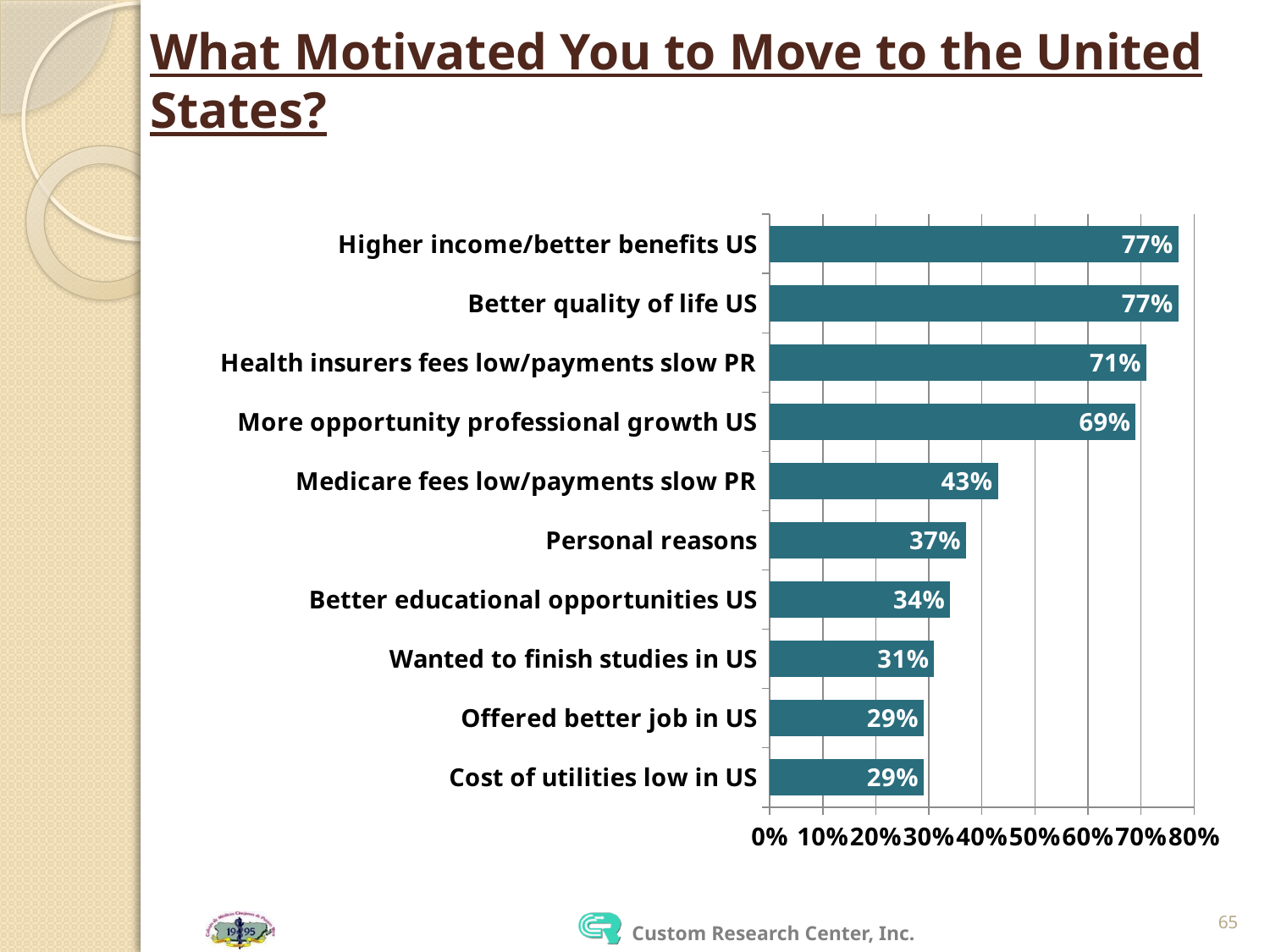
What is the difference between 'Higher income/better benefits US' and 'Medicare fees low/payments slow PR'? 34% What is the title of the slide? What Motivated You to Move to the United States? What percentage is shown for 'Personal reasons'? 37% What is the value for 'Wanted to finish studies in US'? 31% How many categories are shown in the chart? 10 Which category has the lowest value, 'Better educational opportunities US' or 'Offered better job in US'? Offered better job in US What is the value for 'More opportunity professional growth US'? 69% Which is larger, 'Personal reasons' or 'Better educational opportunities US'? Personal reasons What percentage is shown for 'Health insurers fees low/payments slow PR'? 71% What kind of chart is shown on the slide? Bar chart What is the difference between 'Health insurers fees low/payments slow PR' and 'More opportunity professional growth US'? 2% What is the value for 'Medicare fees low/payments slow PR'? 43%